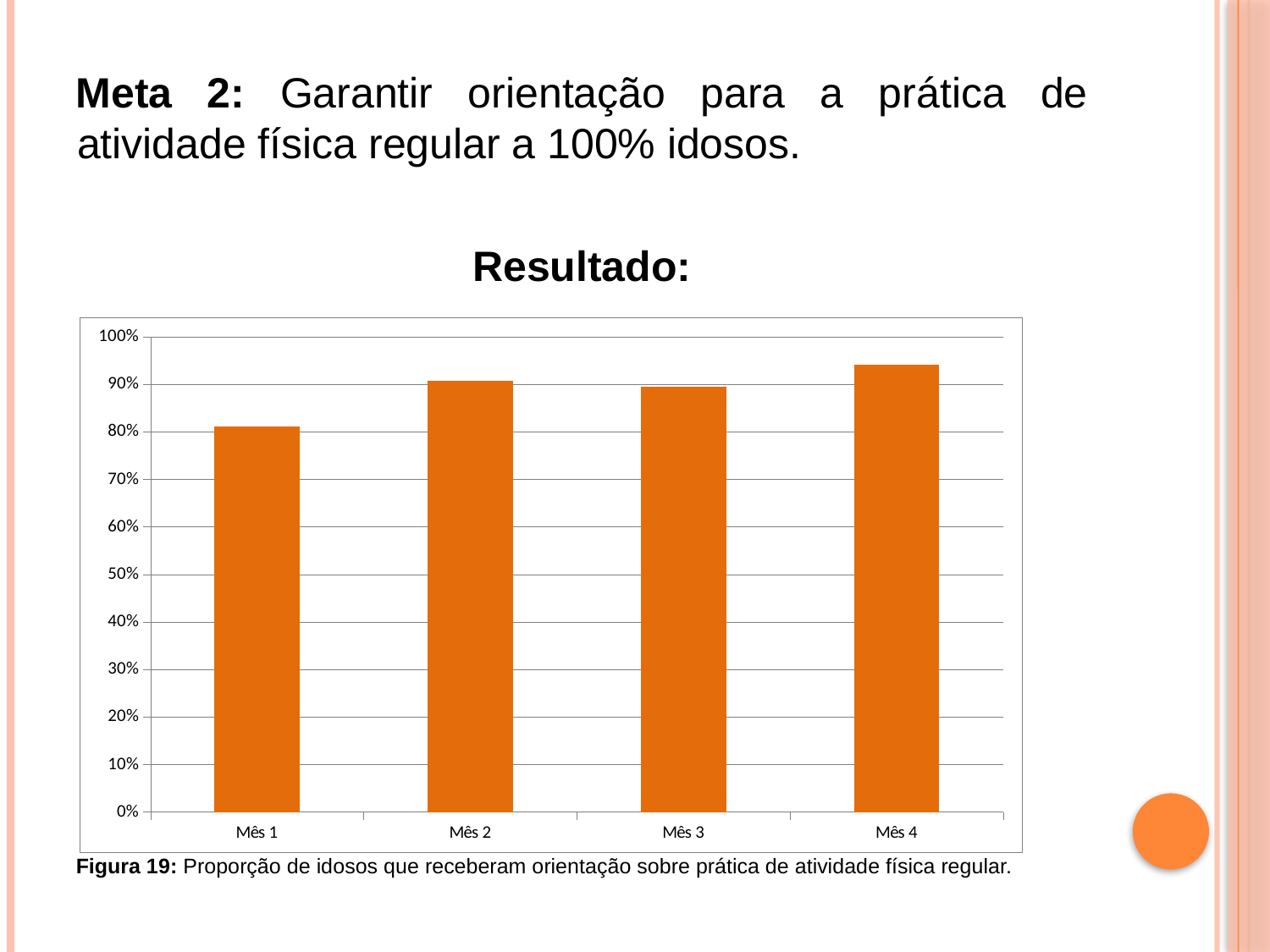
Which is larger, the value for Mês 2 or the value for Mês 3? Mês 2 Is the value for Mês 4 greater or less than 100%? less Does the value rise or fall from Mês 1 to Mês 2? rise Is the value for Mês 2 greater or less than 80%? greater Which month has the lowest bar on the chart? Mês 1 Is the value for Mês 4 greater or less than 90%? greater How many months (categories) are plotted on the chart? 4 What kind of chart is shown on the slide? bar chart What is the figure number given in the caption below the chart? Figura 19 Which month has the highest bar on the chart? Mês 4